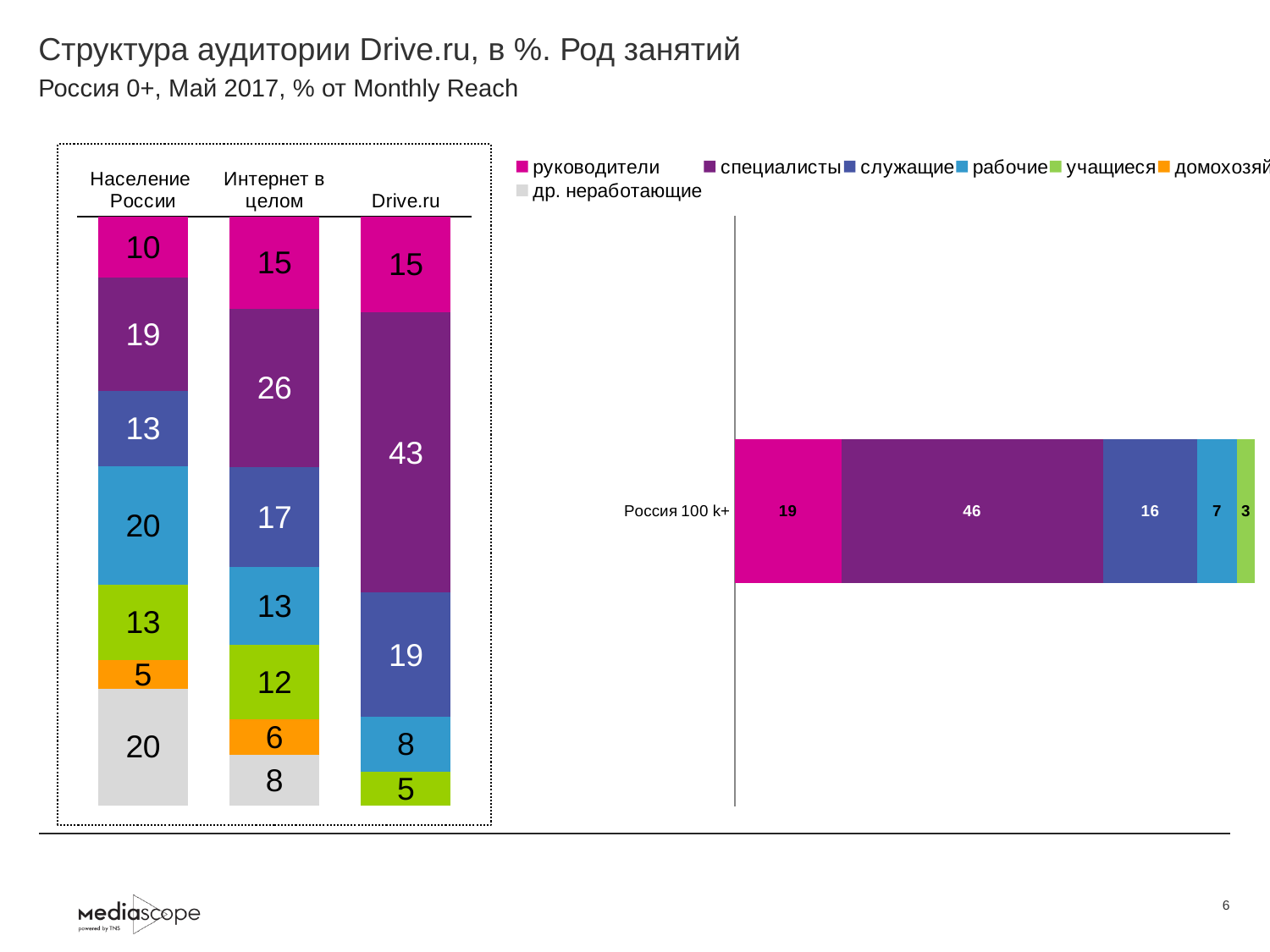
In the left chart, what is the value for рабочие in the Население России bar? 20 What kind of chart is the right chart? stacked bar chart In the left chart, which bar has the lowest value for руководители? Население России In the left chart, what is the difference between the специалисты values for Drive.ru and Интернет в целом? 17 In the left chart, which bar has the highest value for специалисты? Drive.ru In the left chart, which is larger: the рабочие value for Население России or for Drive.ru? Население России In the left chart, what is the value for специалисты in the Drive.ru bar? 43 In the left chart, what is the value for служащие in the Интернет в целом bar? 17 How many bars are shown in the left chart? 3 In the right chart, what is the value for специалисты for Россия 100 k+? 46 How many series does the legend list? 7